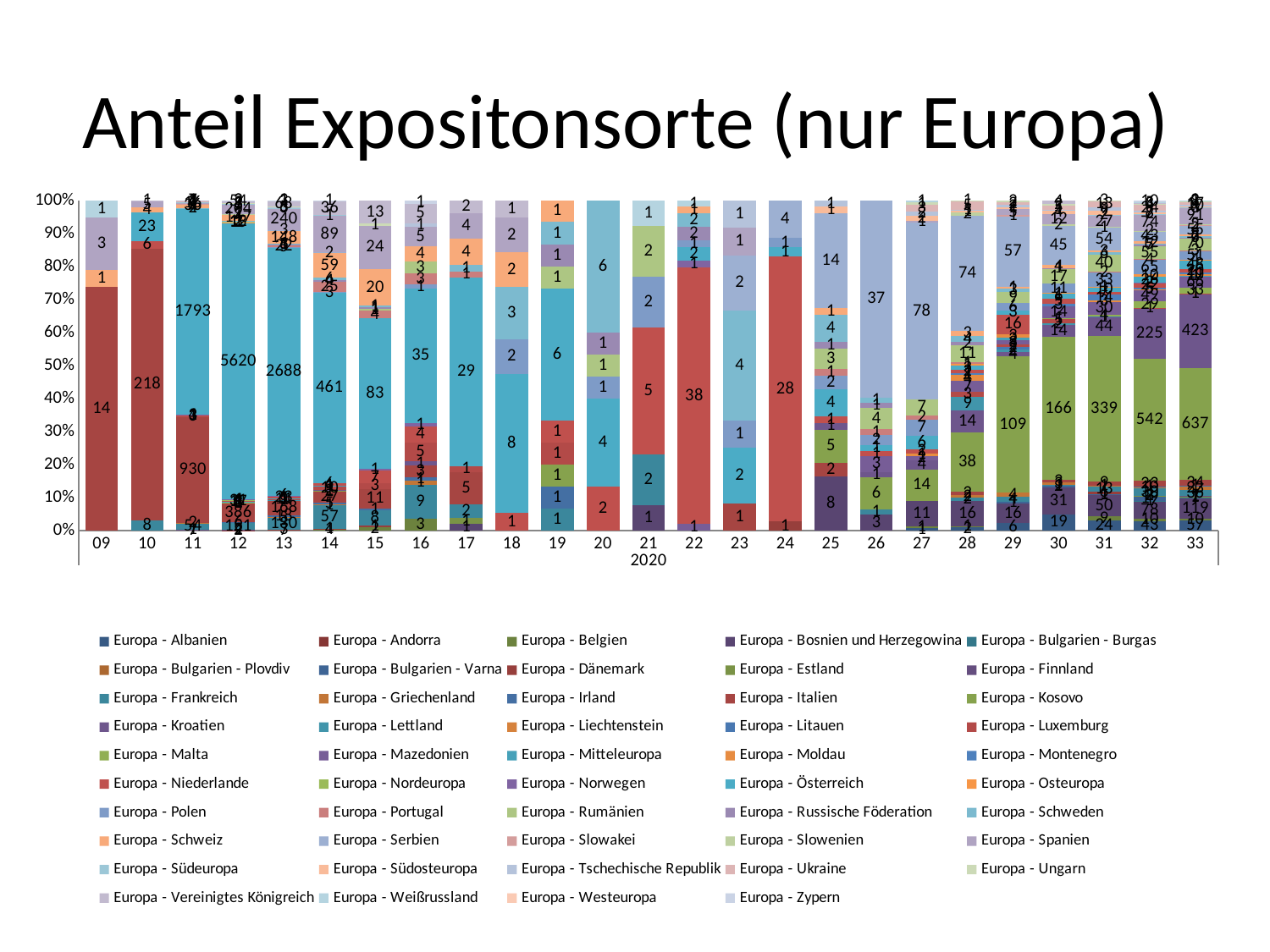
Which is larger, the largest data label in the bar for week 12 or the largest data label in the bar for week 13? week 12 What year label is shown beneath the x axis? 2020 What is the largest data label printed in the bar for week 33? 637 What is the largest data label printed in the bar for week 12? 5620 What is the title of the chart? Anteil Expositonsorte (nur Europa) What is the first category shown on the x axis? 09 What is the largest data label printed in the bar for week 32? 542 How many series does the legend list? 49 How many categories (weeks) are shown along the x axis? 25 What is the largest data label printed in the bar for week 11? 1793 What is the largest data label printed in the bar for week 13? 2688 What kind of chart is shown on the slide? stacked bar chart